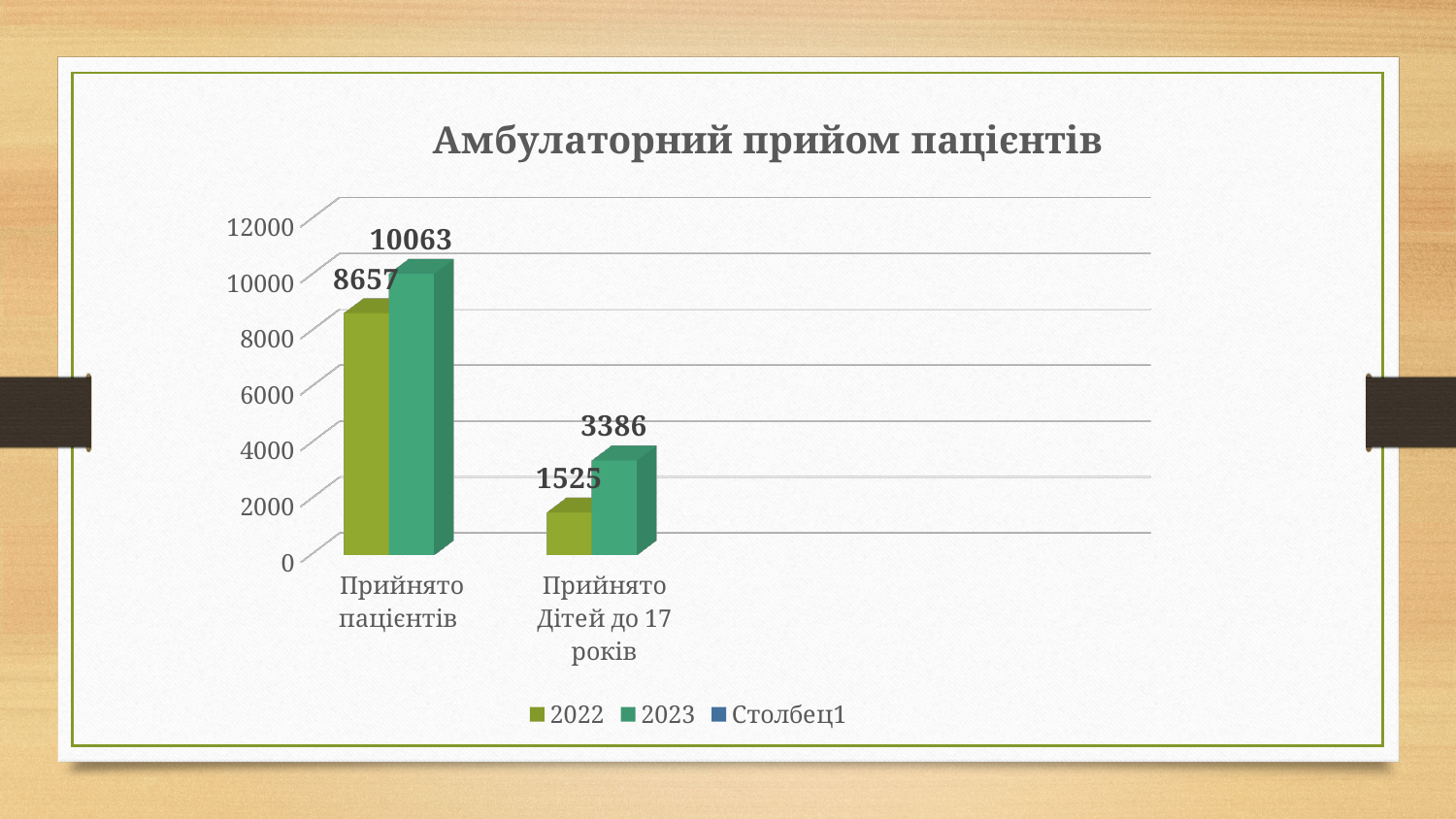
What is the value for 2023 in the category "Прийнято пацієнтів"? 10063 What is the difference between the 2023 and 2022 values for "Прийнято Дітей до 17 років"? 1861 Which bar has the lowest value in the chart? 2022, Прийнято Дітей до 17 років What is the title of the chart? Амбулаторний прийом пацієнтів Which bar has the highest value in the chart? 2023, Прийнято пацієнтів What is the difference between the 2023 and 2022 values for "Прийнято пацієнтів"? 1406 What is the value for 2022 in the category "Прийнято пацієнтів"? 8657 Which series has the higher value for "Прийнято пацієнтів", 2022 or 2023? 2023 How many series does the legend list? 3 What is the value for 2023 in the category "Прийнято Дітей до 17 років"? 3386 How many categories are shown on the x axis? 2 What is the value for 2022 in the category "Прийнято Дітей до 17 років"? 1525